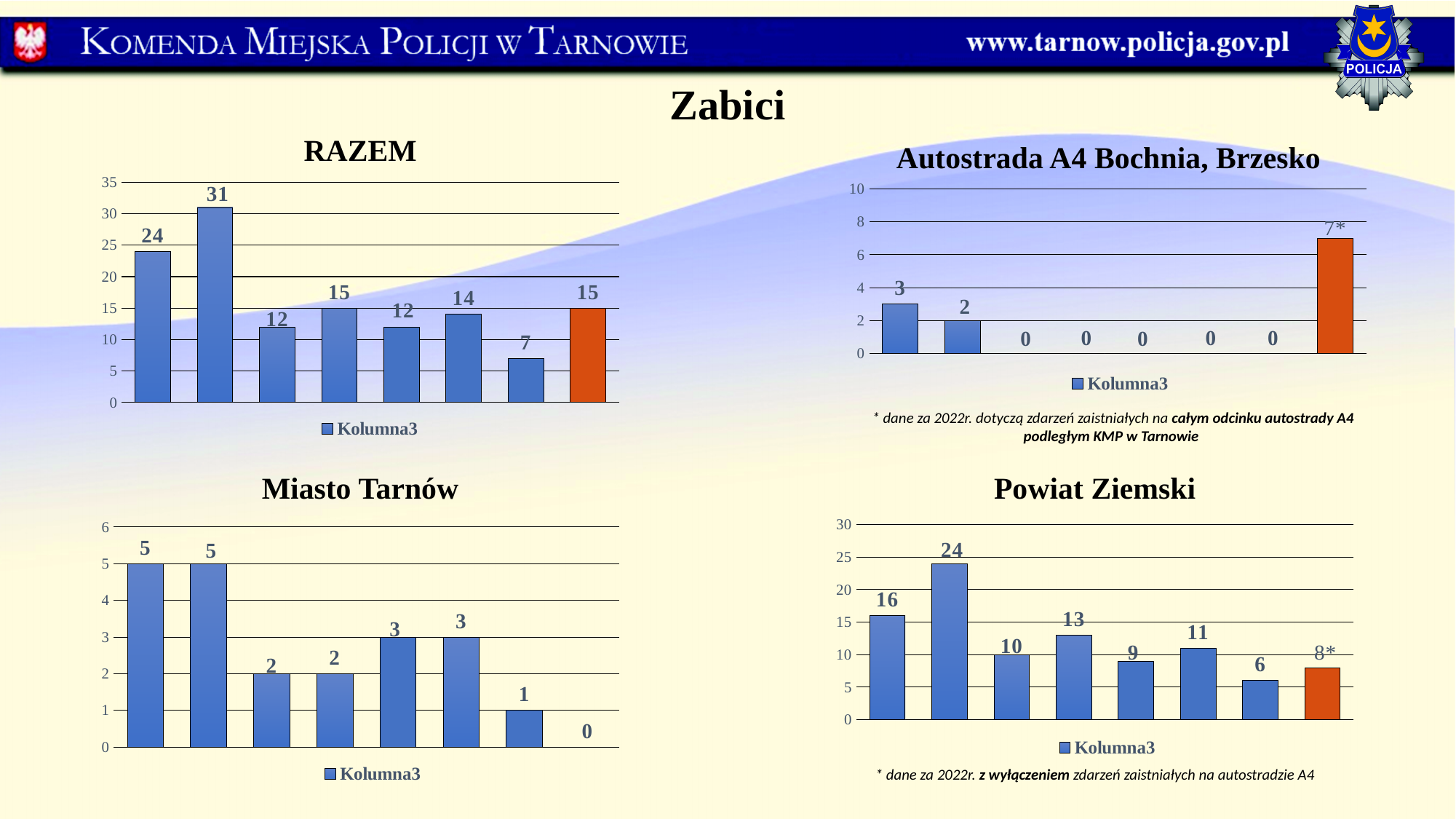
In the Powiat Ziemski chart, what is the highest value shown? 24 In the RAZEM chart, what is the highest value shown? 31 In the Miasto Tarnów chart, what is the highest value shown? 5 In the Miasto Tarnów chart, what is the value of the last bar? 0 In the RAZEM chart, what is the difference between the first bar and the second bar? 7 In the RAZEM chart, what is the value of the last (orange) bar? 15 How many bars are plotted in the RAZEM chart? 8 In the RAZEM chart, what is the lowest value shown? 7 In the Autostrada A4 Bochnia, Brzesko chart, what is the value of the first bar? 3 In the Powiat Ziemski chart, which is larger: the last (orange) bar or the bar immediately before it? the last (orange) bar What type of chart is the Powiat Ziemski chart? bar chart In the Autostrada A4 Bochnia, Brzesko chart, what is the value labelled on the last (orange) bar? 7*